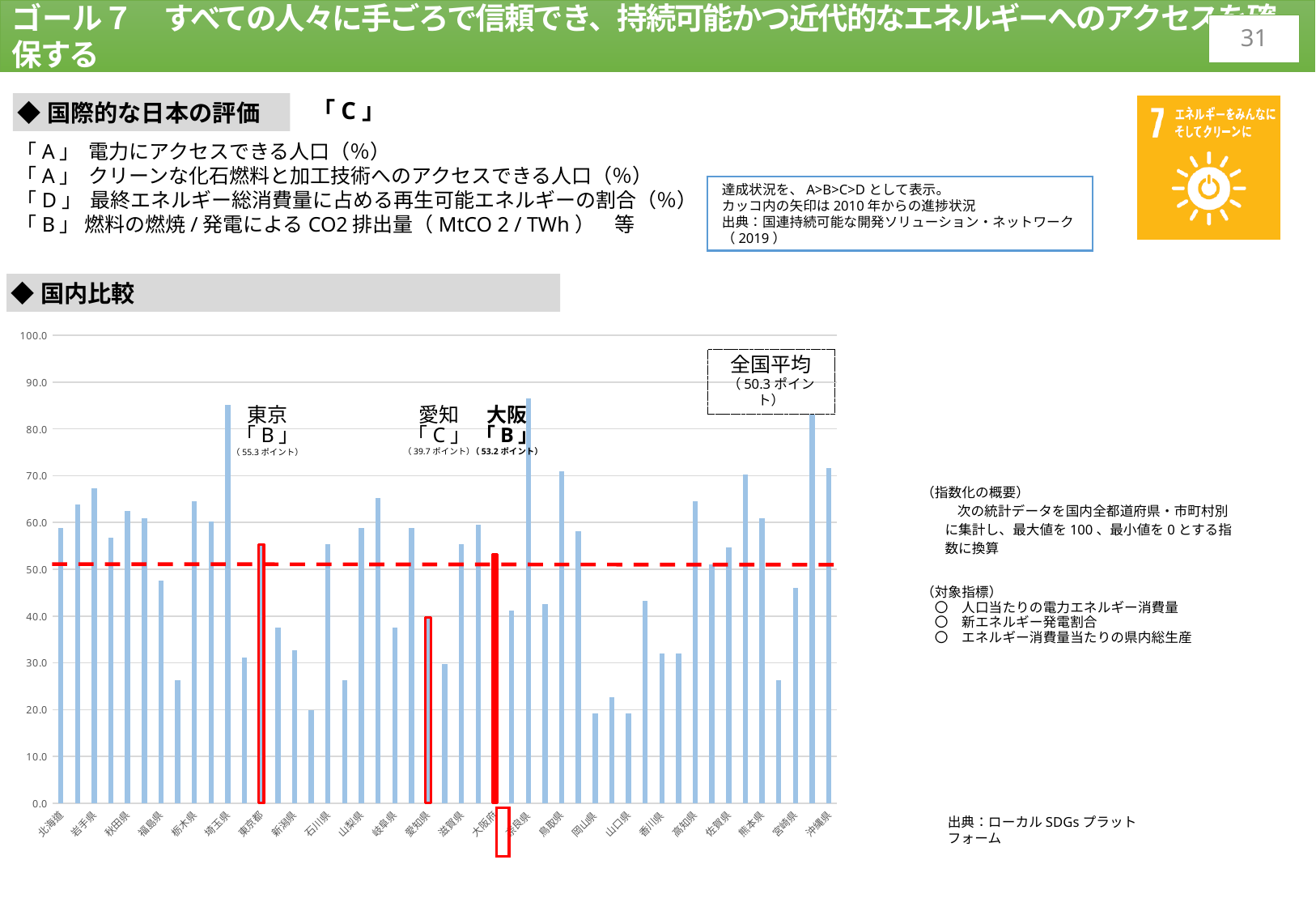
Which has the higher value on the 国内比較 chart, 東京 or 大阪? 東京 Is the value for 石川県 on the 国内比較 chart greater or less than 30.0? greater By how many points does 東京 exceed 大阪 on the 国内比較 chart? 2.1 ポイント What is the value shown for 大阪 on the 国内比較 chart? 53.2 ポイント What is the difference between the values for 東京 and 愛知 on the 国内比較 chart? 15.6 ポイント What is the value shown for 東京 on the 国内比較 chart? 55.3 ポイント Is the value for 沖縄県 on the 国内比較 chart greater or less than 60.0? greater What kind of chart is used in the 国内比較 section? bar chart What rating letter is shown for 愛知 on the 国内比較 chart? C Is the value for 愛知 higher or lower than the 全国平均 on the 国内比較 chart? lower What is the value shown for 愛知 on the 国内比較 chart? 39.7 ポイント What is the 全国平均 value shown on the 国内比較 chart? 50.3 ポイント